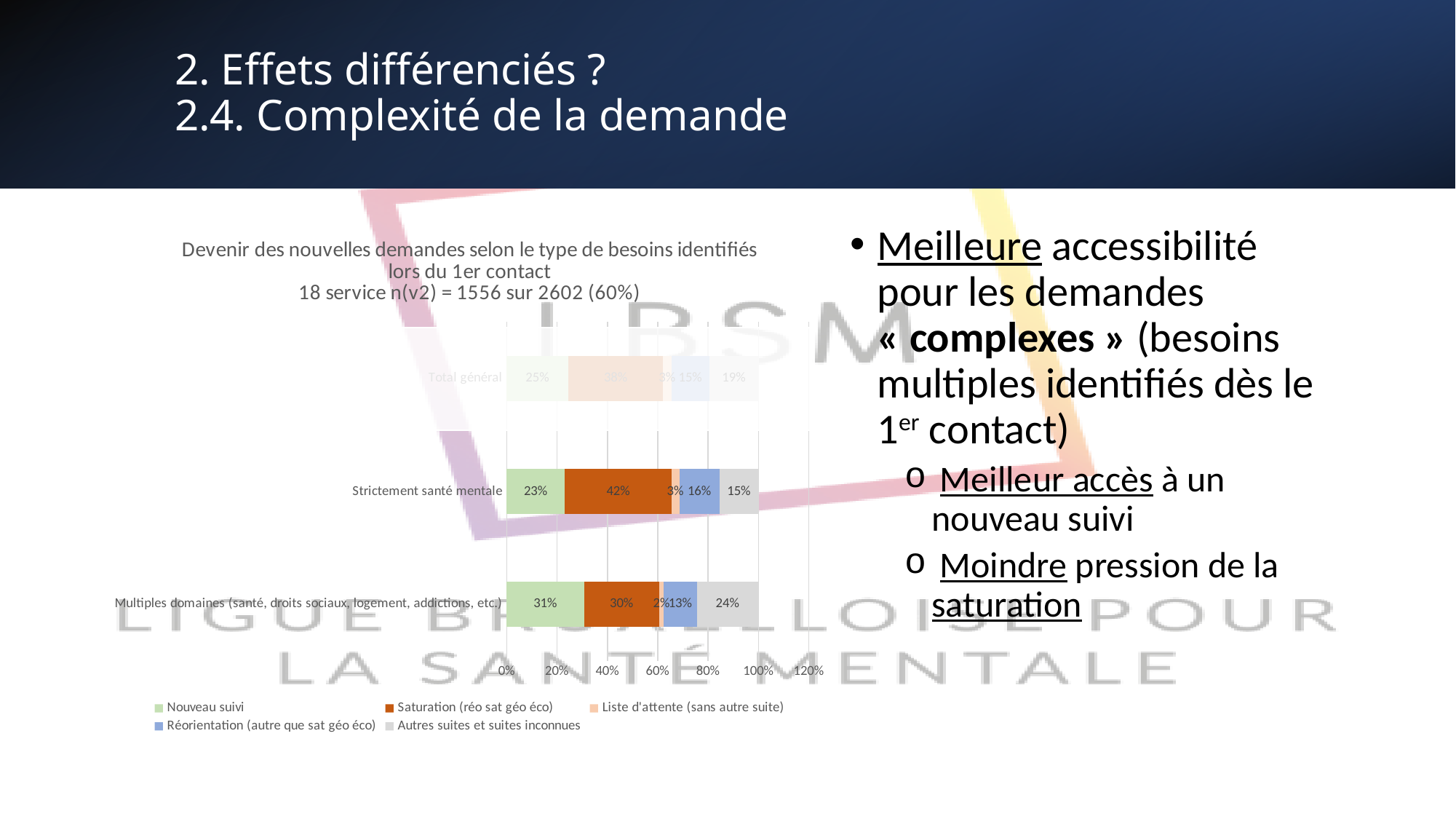
Which category has the highest value for 'Saturation (réo sat géo éco)'? Strictement santé mentale How many series does the legend list? 5 What is the value of 'Saturation (réo sat géo éco)' for 'Strictement santé mentale'? 42% What kind of chart is shown on the slide? stacked bar chart What is the value of 'Nouveau suivi' for 'Multiples domaines (santé, droits sociaux, logement, addictions, etc.)'? 31% What is the value of 'Autres suites et suites inconnues' for 'Multiples domaines (santé, droits sociaux, logement, addictions, etc.)'? 24% What is the difference between the 'Saturation (réo sat géo éco)' values for 'Strictement santé mentale' and 'Multiples domaines (santé, droits sociaux, logement, addictions, etc.)'? 12% Which category has the lowest value for 'Nouveau suivi'? Strictement santé mentale What is the value of 'Nouveau suivi' for 'Total général'? 25% Which is larger: 'Nouveau suivi' for 'Multiples domaines (santé, droits sociaux, logement, addictions, etc.)' or 'Nouveau suivi' for 'Strictement santé mentale'? Multiples domaines (santé, droits sociaux, logement, addictions, etc.) What is the value of 'Réorientation (autre que sat géo éco)' for 'Strictement santé mentale'? 16% How many categories are plotted on the y axis? 3